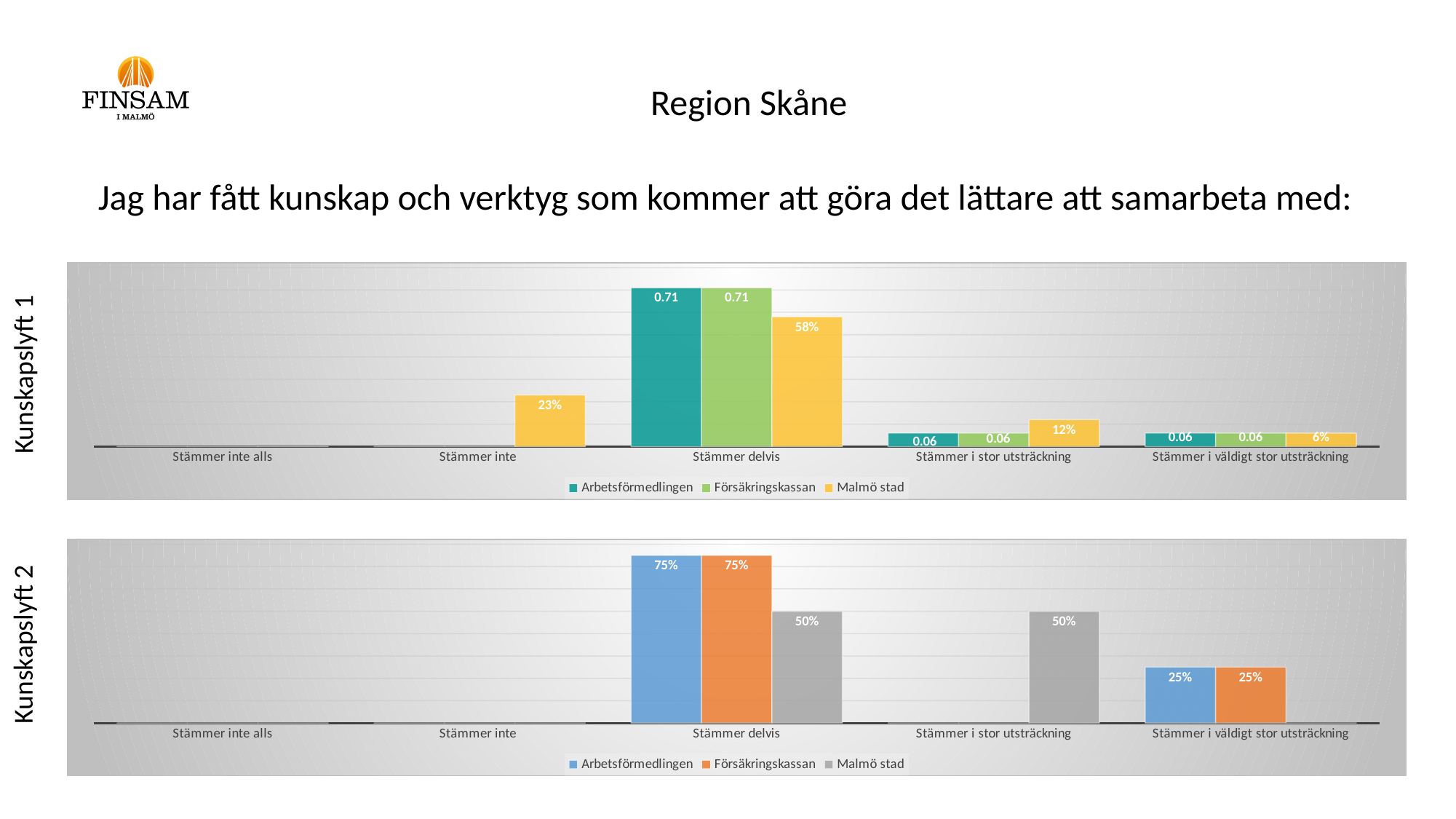
In the Kunskapslyft 1 chart, what is the difference between Malmö stad's values at 'Stämmer delvis' and 'Stämmer i stor utsträckning'? 46% In the Kunskapslyft 2 chart, what is the value for Malmö stad at 'Stämmer i stor utsträckning'? 50% What kind of chart is the Kunskapslyft 2 chart? Bar chart In the Kunskapslyft 2 chart, which is larger at 'Stämmer delvis': Arbetsförmedlingen or Malmö stad? Arbetsförmedlingen In the Kunskapslyft 1 chart, how many series does the legend list? 3 In the Kunskapslyft 2 chart, what is the value for Arbetsförmedlingen at 'Stämmer i väldigt stor utsträckning'? 25% In the Kunskapslyft 2 chart, what is the value for Försäkringskassan at 'Stämmer delvis'? 75% In the Kunskapslyft 1 chart, what is the value for Malmö stad at 'Stämmer i stor utsträckning'? 12% In the Kunskapslyft 2 chart, how many categories are shown on the x axis? 5 In the Kunskapslyft 1 chart, which category has the highest value for Malmö stad? Stämmer delvis In the Kunskapslyft 1 chart, what is the value for Arbetsförmedlingen at 'Stämmer delvis'? 0.71 In the Kunskapslyft 1 chart, what is the value for Malmö stad at 'Stämmer inte'? 23%